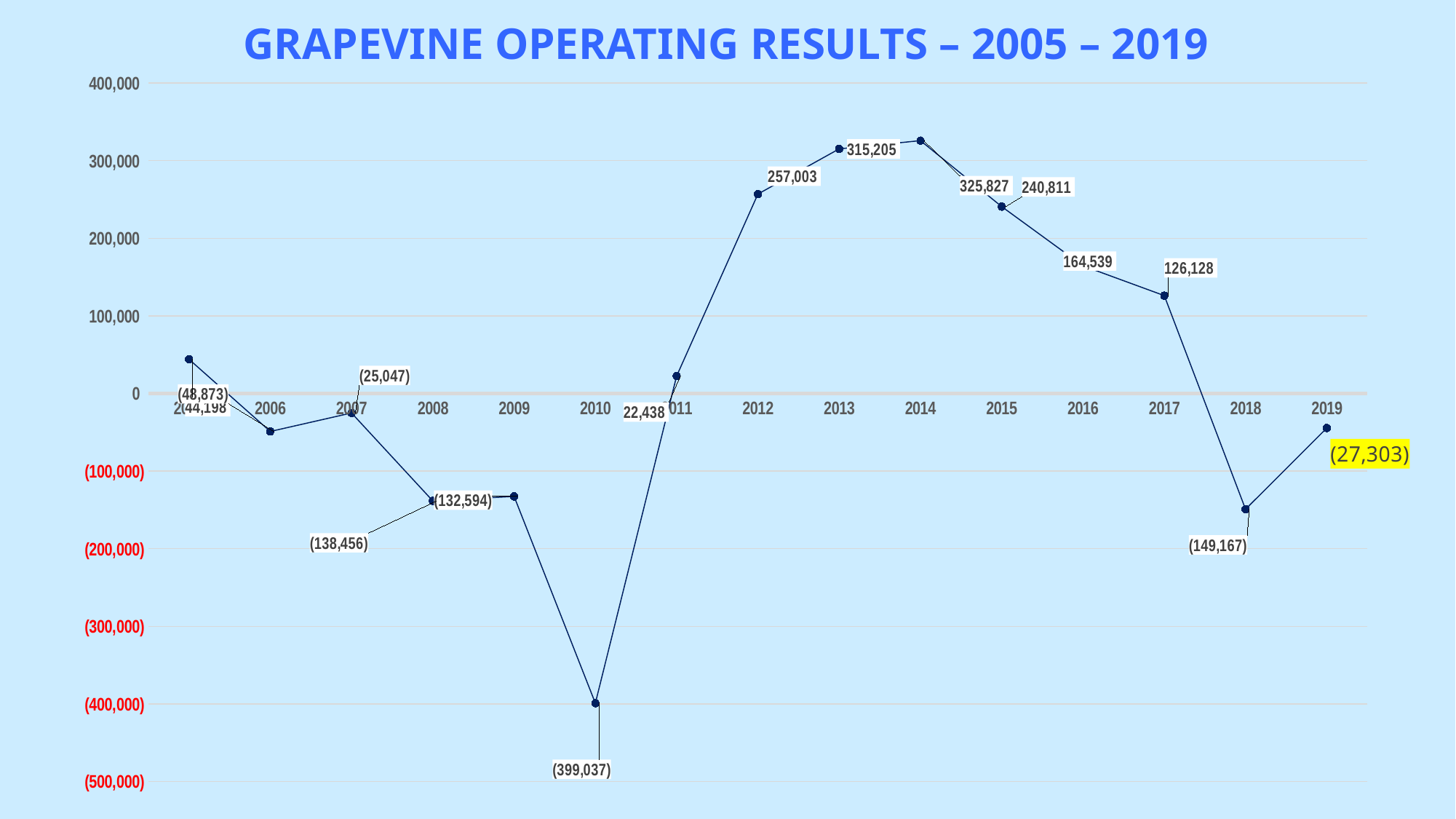
What is the title of the chart? GRAPEVINE OPERATING RESULTS – 2005 – 2019 What is the operating result for 2013? 315,205 Which year has the highest operating result? 2014 What is the operating result for 2019? (27,303) How many years are plotted on the x axis? 15 What is the operating result for 2010? (399,037) Which year has the larger operating result, 2012 or 2015? 2012 Which year has the lowest operating result? 2010 What is the operating result for 2018? (149,167) What is the difference between the 2013 and 2012 operating results? 58,202 What kind of chart is shown on the slide? line chart Is the value for 2005 greater or less than 0? greater